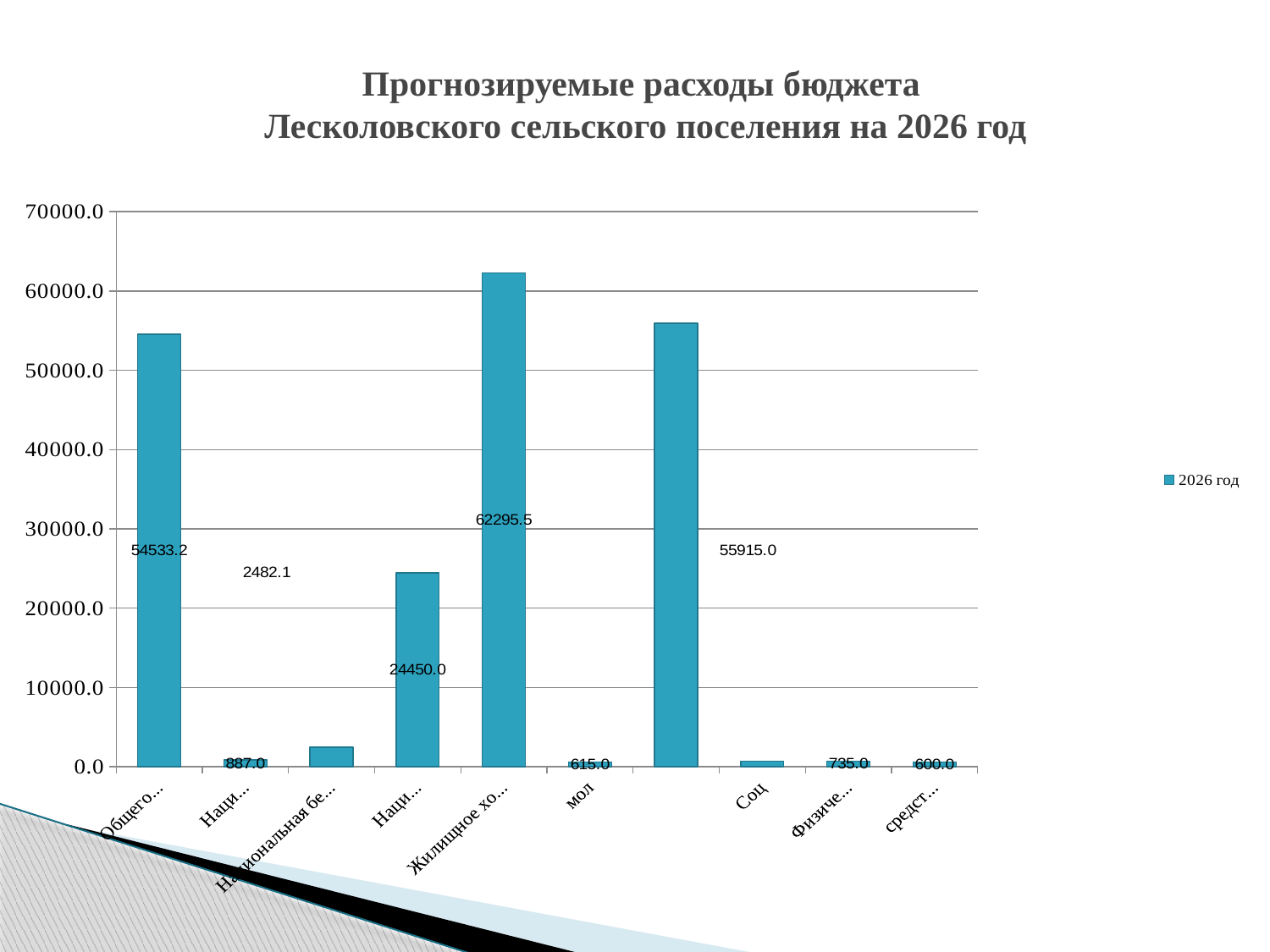
How many bars are plotted in the chart? 10 Is the value of the fourth bar (Наци...) greater or less than 20000.0? greater How many series does the legend list? 1 What is the value of the bar labelled 'мол'? 615.0 What is the title of the chart? Прогнозируемые расходы бюджета Лесколовского сельского поселения на 2026 год Which bar has the highest value? the fifth bar (Жилищное хо...), 62295.5 What is the difference between the fifth bar (62295.5) and the seventh bar (55915.0)? 6380.5 What is the value of the fifth bar (Жилищное хо...)? 62295.5 Which is larger: the first bar (54533.2) or the seventh bar (55915.0)? the seventh bar (55915.0) What is the value of the first bar (Общего...)? 54533.2 What is the legend entry for the series? 2026 год What kind of chart is shown on the slide? bar chart